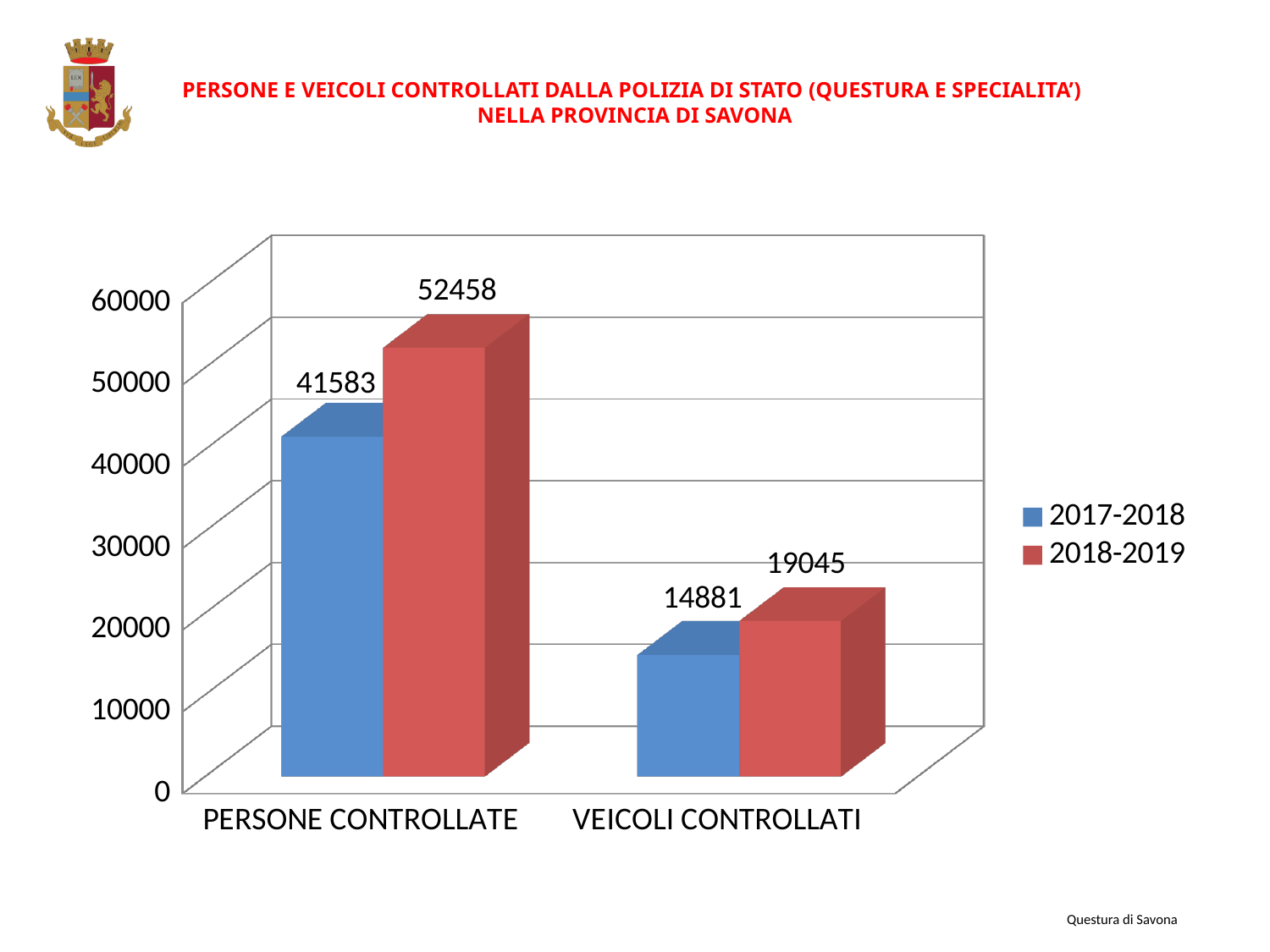
What is the value for PERSONE CONTROLLATE in the 2017-2018 series? 41583 What is the value for VEICOLI CONTROLLATI in the 2017-2018 series? 14881 What is the value for PERSONE CONTROLLATE in the 2018-2019 series? 52458 How many series does the legend list? 2 Which is larger for VEICOLI CONTROLLATI: the 2017-2018 value or the 2018-2019 value? 2018-2019 Which category has the highest value in the 2018-2019 series? PERSONE CONTROLLATE What kind of chart is shown on the slide? Bar chart How many categories are shown on the x axis? 2 Which category has the lowest value in the 2017-2018 series? VEICOLI CONTROLLATI What is the difference between the 2018-2019 and 2017-2018 values for PERSONE CONTROLLATE? 10875 What is the difference between the 2018-2019 and 2017-2018 values for VEICOLI CONTROLLATI? 4164 What is the value for VEICOLI CONTROLLATI in the 2018-2019 series? 19045